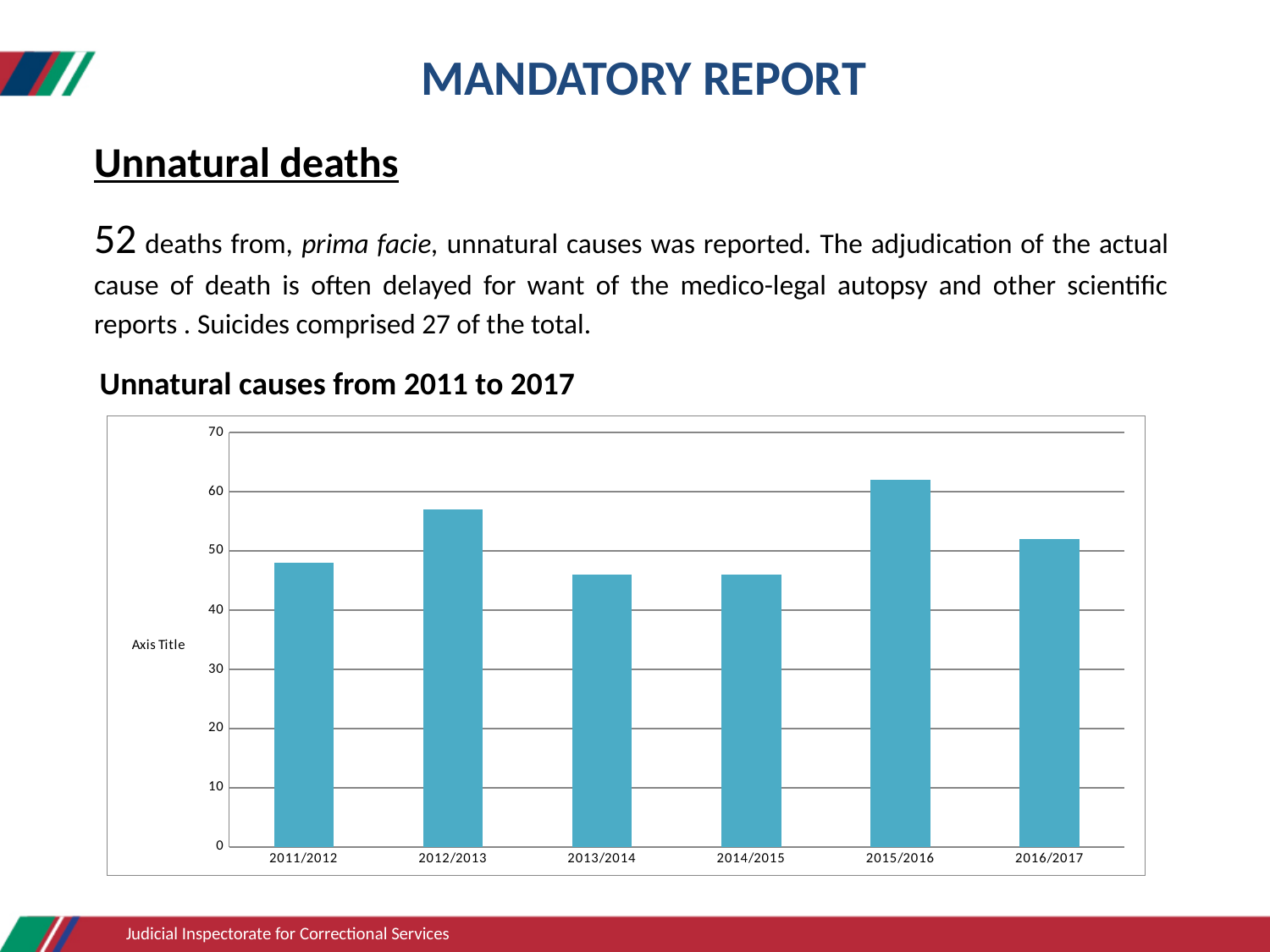
Which is larger, the value for 2011/2012 or the value for 2014/2015? 2011/2012 Is the value for 2016/2017 greater or less than 50? greater Which year has the highest bar in the chart? 2015/2016 Is the value for 2013/2014 greater or less than 50? less Does the value rise or fall from 2015/2016 to 2016/2017? fall Is the value for 2011/2012 greater or less than 50? less How many financial years are shown on the x axis of the chart? 6 What is the title given above the chart? Unnatural causes from 2011 to 2017 What kind of chart is shown on the slide? bar chart Which is larger, the value for 2012/2013 or the value for 2016/2017? 2012/2013